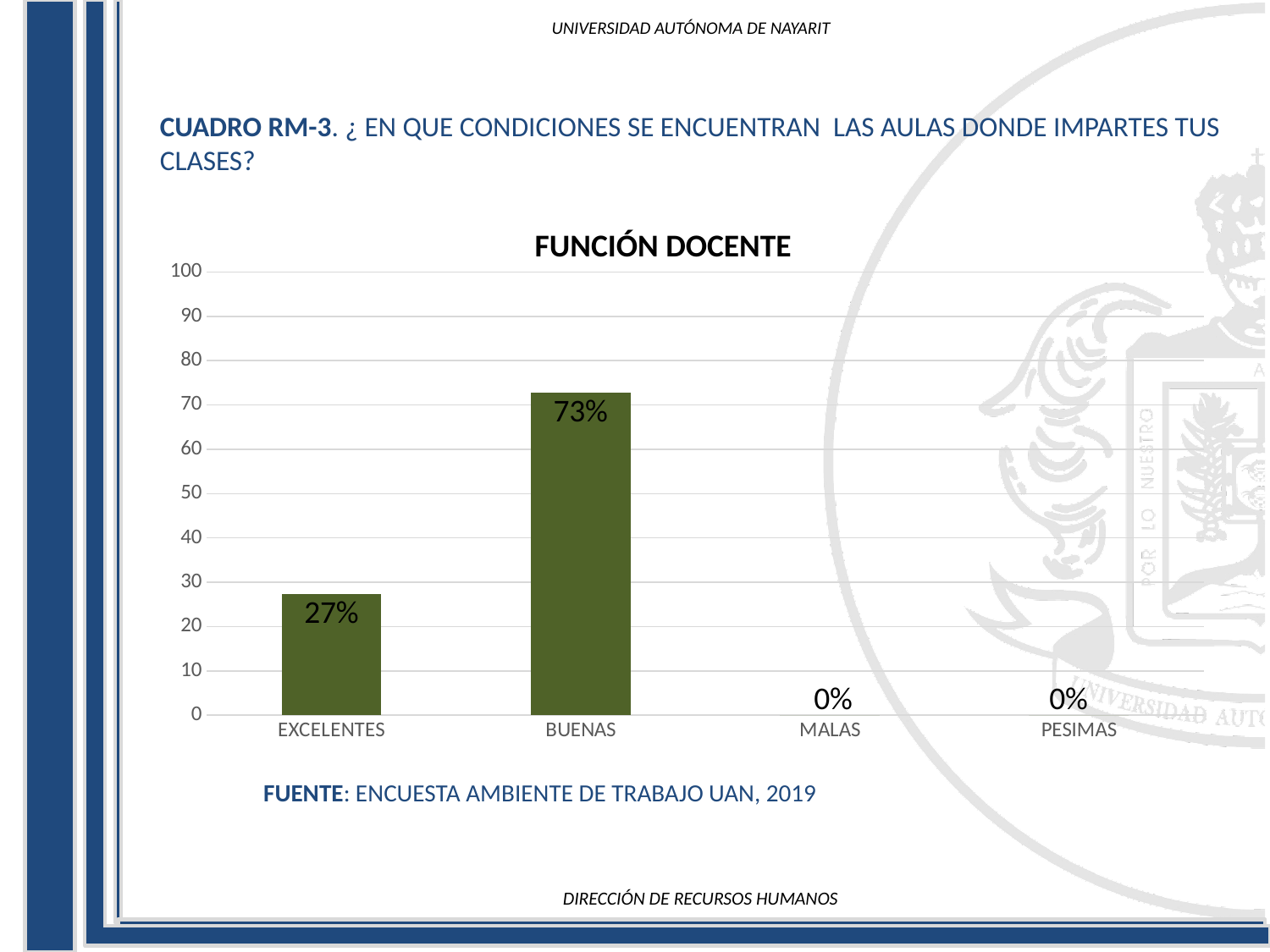
What is the title of the chart? FUNCIÓN DOCENTE What is the value for EXCELENTES? 27% How many categories are shown on the x axis? 4 Is the value for BUENAS greater or less than 70? greater Is the value for EXCELENTES greater or less than 30? less What is the value for BUENAS? 73% What is the value for MALAS? 0% Which is larger, the value for EXCELENTES or the value for BUENAS? BUENAS Which category has the highest value? BUENAS What kind of chart is shown on the slide? bar chart What is the difference between the values for BUENAS and EXCELENTES? 46% What is the value for PESIMAS? 0%